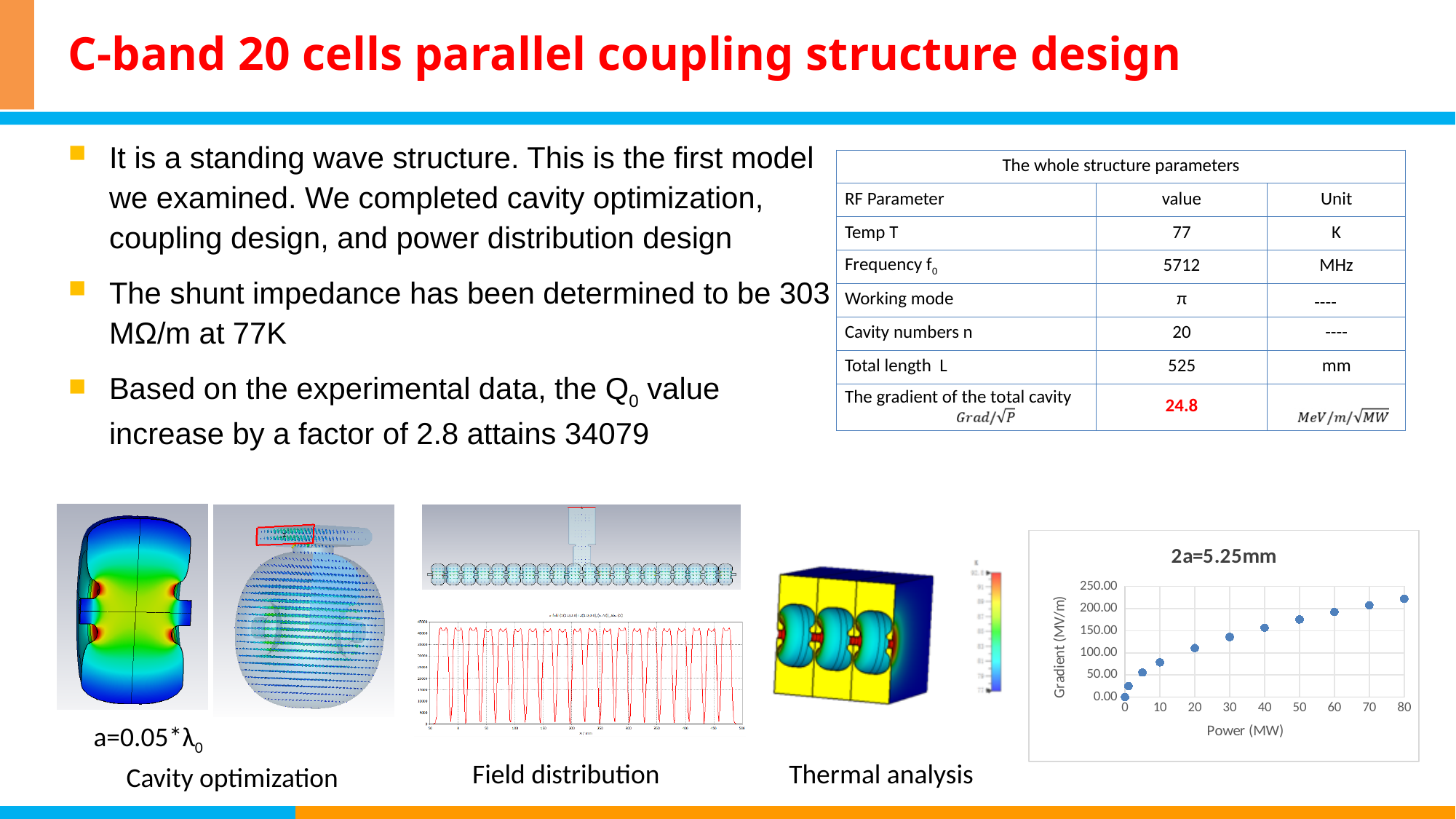
In the chart titled "2a=5.25mm", is the gradient at 10 MW greater or less than 100.00? less In the chart titled "2a=5.25mm", which has the larger gradient: 60 MW or 30 MW? 60 MW In the chart titled "2a=5.25mm", is the gradient at 80 MW greater or less than 200.00? greater In the chart titled "2a=5.25mm", is the gradient at 20 MW greater or less than 150.00? less In the chart titled "2a=5.25mm", at which power value is the gradient highest? 80 MW In the chart titled "2a=5.25mm", does the gradient rise or fall as power increases along the x axis? rise What is the label of the x axis of the chart titled "2a=5.25mm"? Power (MW) What kind of chart is the chart titled "2a=5.25mm"? scatter chart What is the label of the y axis of the chart titled "2a=5.25mm"? Gradient (MV/m)